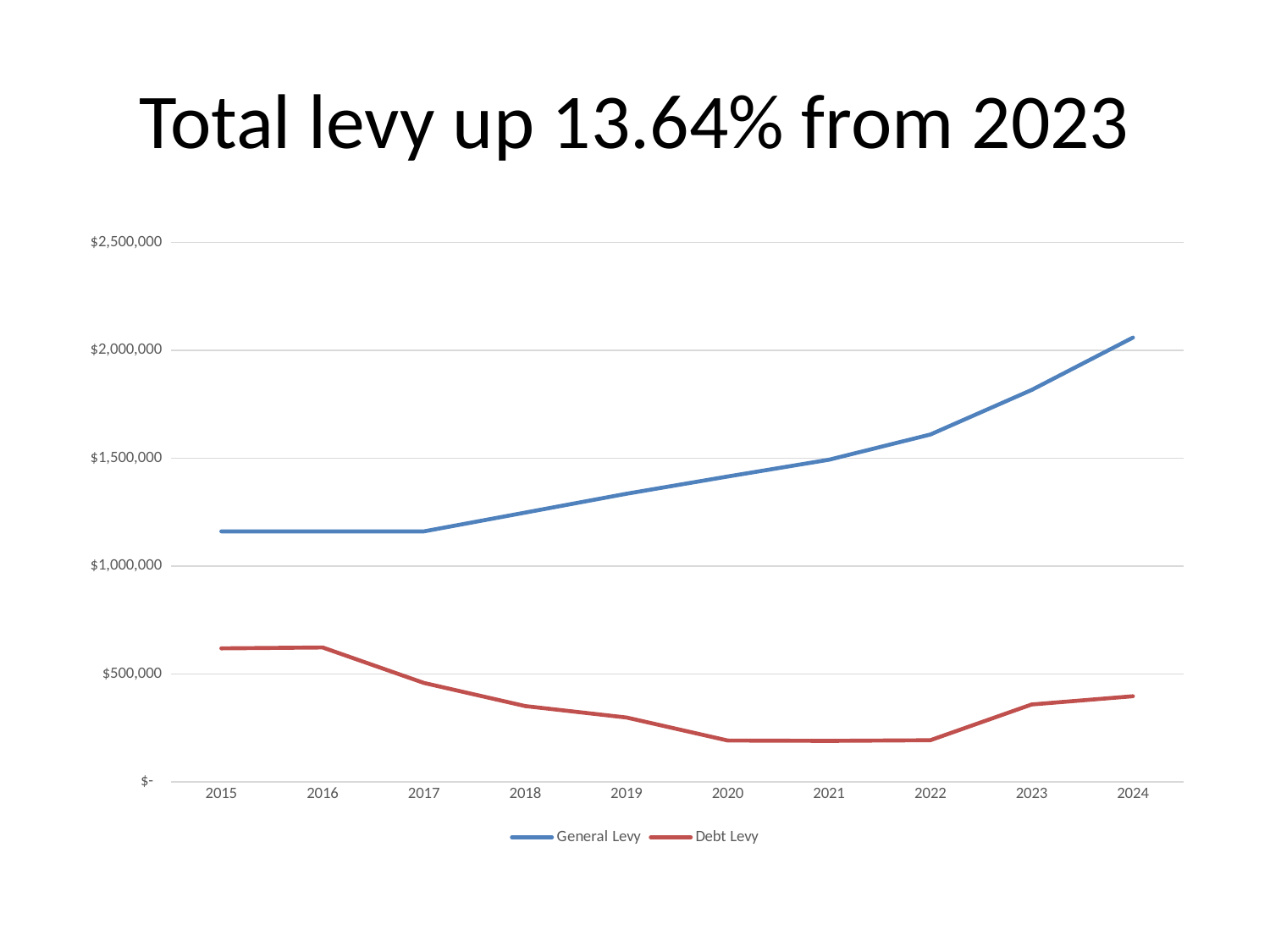
Is the General Levy value for 2024 greater or less than $2,000,000? greater Is the General Levy value for 2015 greater or less than $1,000,000? greater Is the General Levy value for 2022 greater or less than $1,500,000? greater What is the title of the slide? Total levy up 13.64% from 2023 How many series does the legend list? 2 How many years are plotted along the x axis? 10 In which year is the General Levy highest? 2024 In 2024, which is larger, the General Levy or the Debt Levy? General Levy What kind of chart is shown on the slide? line chart Does the General Levy rise or fall from 2017 to 2024? rise